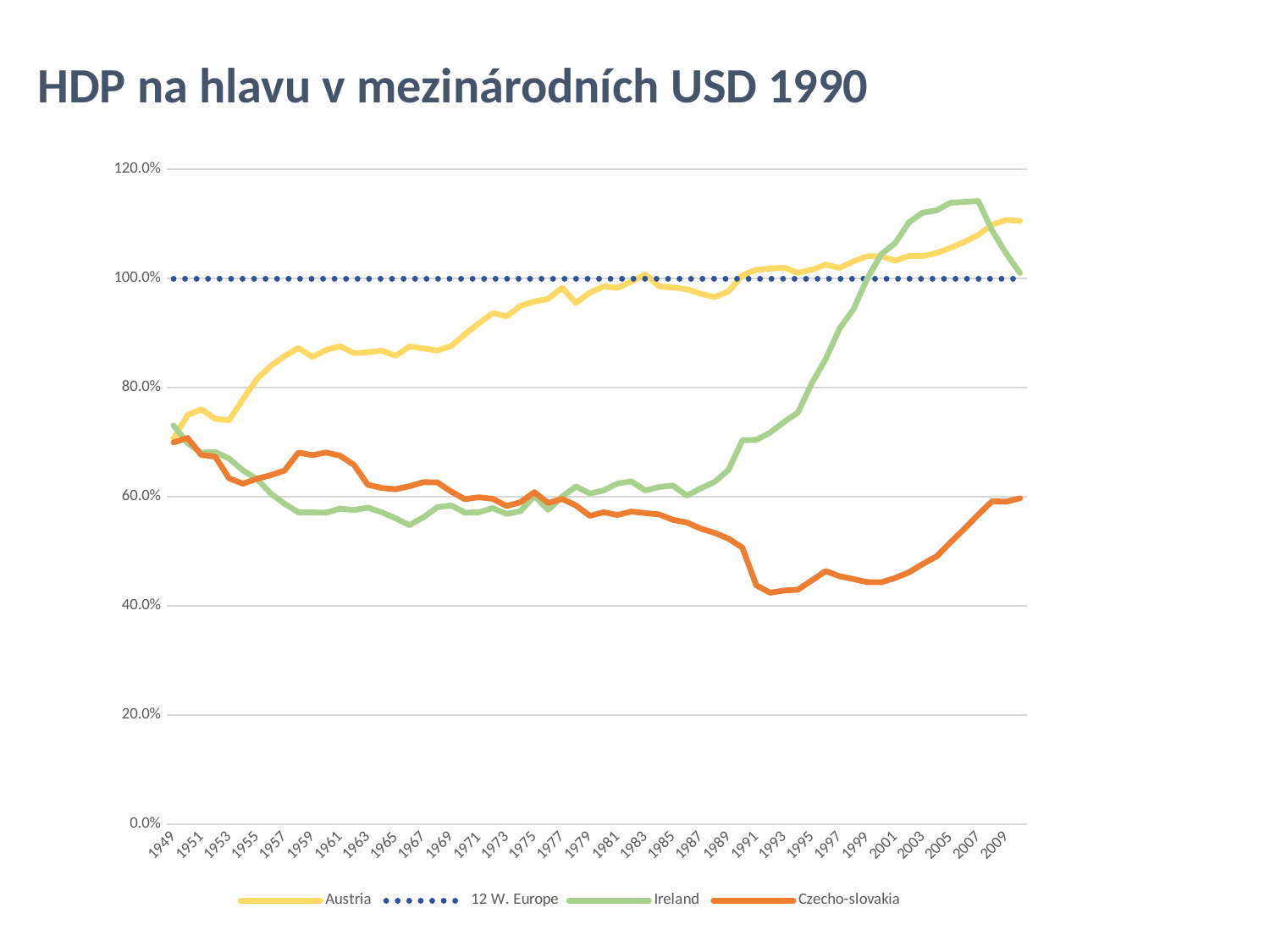
At what value does the 12 W. Europe line stay throughout the chart? 100.0% What is the title of the chart? HDP na hlavu v mezinárodních USD 1990 What kind of chart is shown on the slide? line chart Is the value for Ireland in 2007 greater or less than 100%? greater Is the value for Czecho-slovakia in 1993 greater or less than 60%? less Is the value for Ireland in 1967 greater or less than 60%? less Which series has the lowest value in 2009? Czecho-slovakia How many series does the legend list? 4 Which series has the highest value in 2007? Ireland In 2001, which is larger: the value for Ireland or the value for Czecho-slovakia? Ireland Which series is drawn as a dotted line? 12 W. Europe